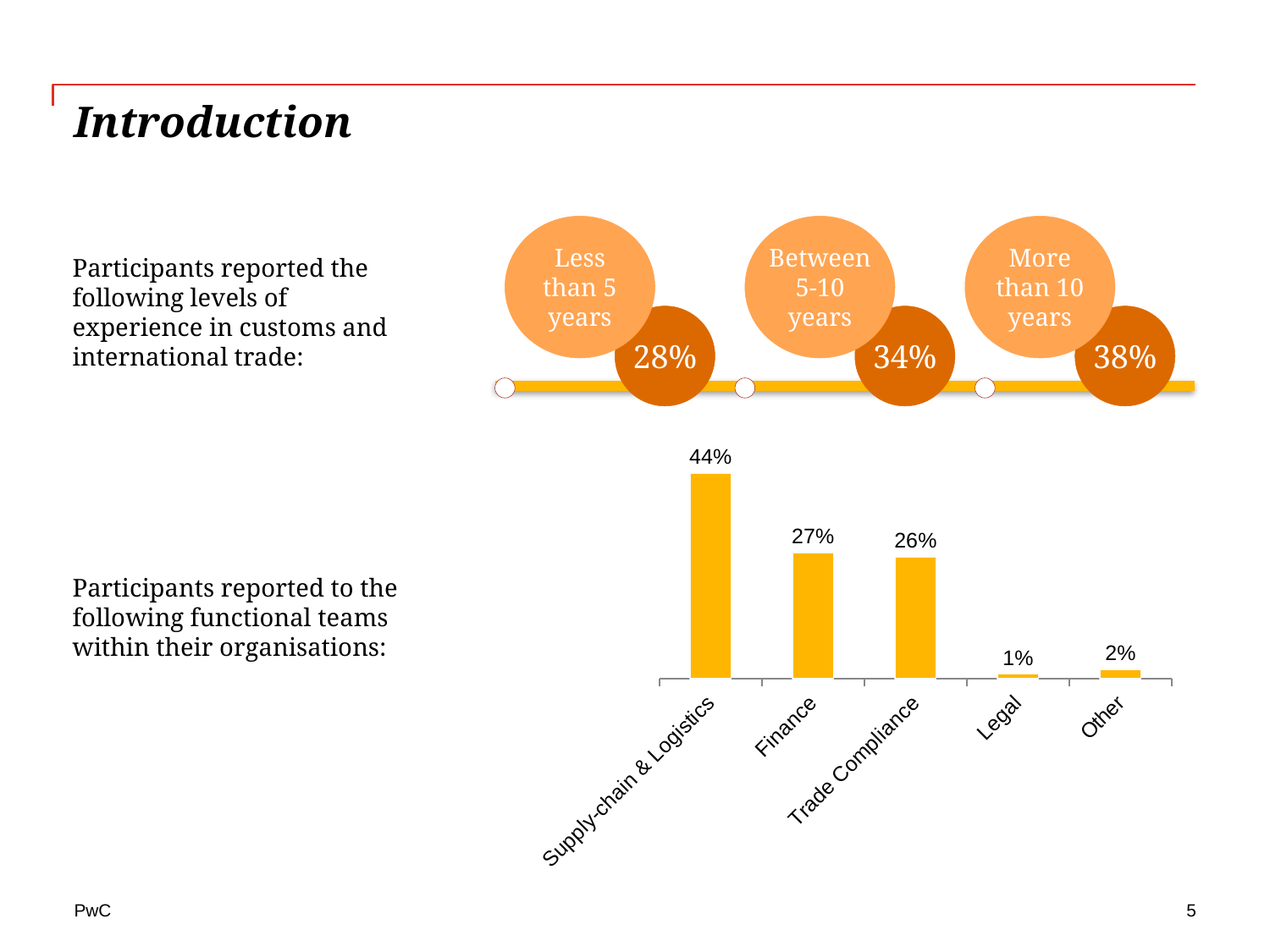
In the bar chart of functional teams, which functional team has the lowest share of participants? Legal In the experience graphic at the top right, which experience level has the lowest percentage of participants? Less than 5 years In the bar chart of functional teams, what is the value for Trade Compliance? 26% In the bar chart of functional teams, what percentage of participants reported to Supply-chain & Logistics? 44% In the bar chart of functional teams, what is the value for Legal? 1% In the bar chart of functional teams, what is the value for Finance? 27% In the bar chart of functional teams, what is the difference between the values for Supply-chain & Logistics and Finance? 17% In the experience graphic at the top right, what percentage of participants reported more than 10 years of experience? 38% How many functional team categories are shown in the bar chart? 5 What type of chart is used to show the functional teams participants reported to? Bar chart In the bar chart of functional teams, which functional team has the highest share of participants? Supply-chain & Logistics In the bar chart of functional teams, which is larger, the value for Other or the value for Legal? Other